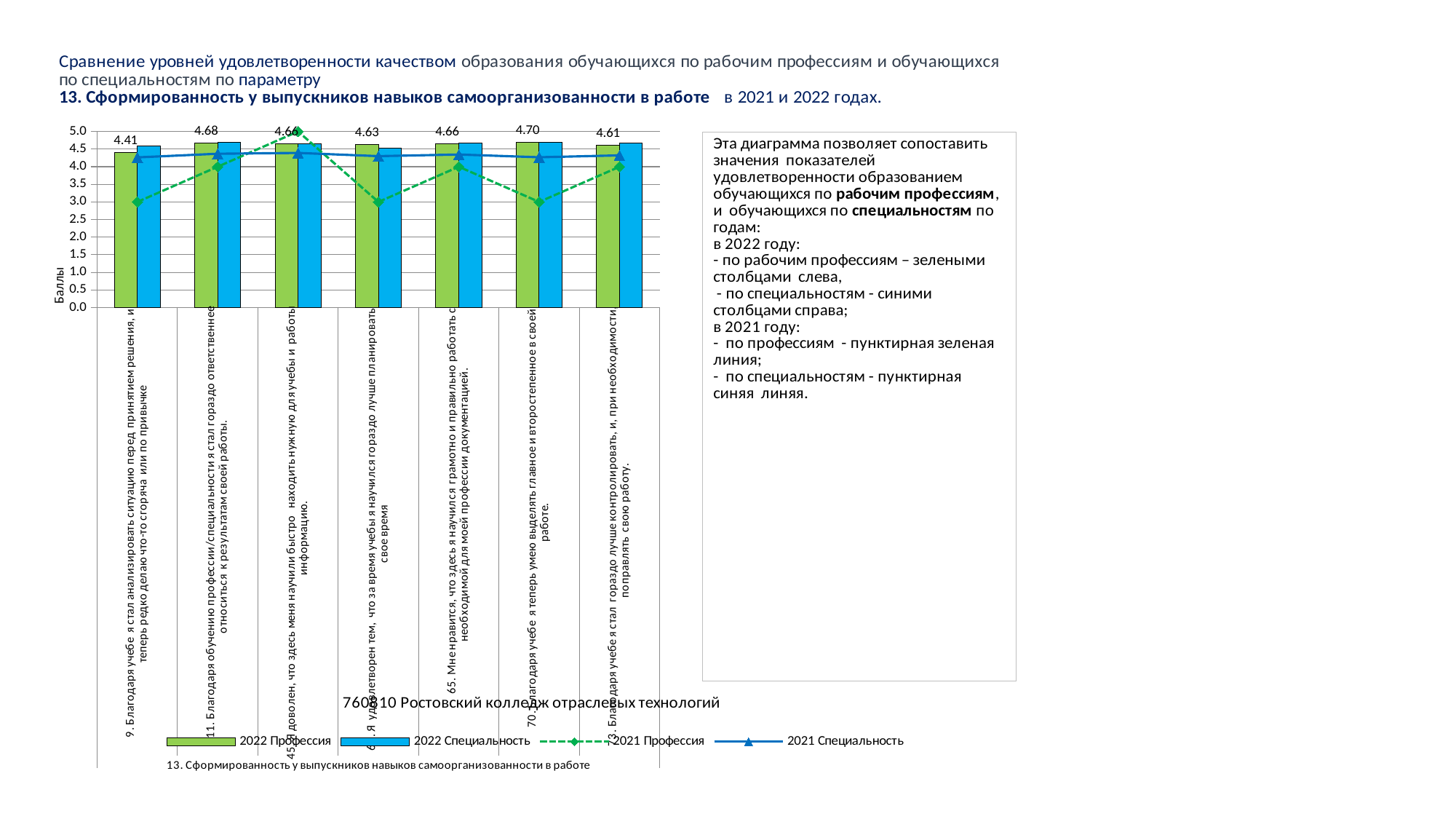
What is the title of the vertical axis of the chart? Баллы What is the value of the 2022 Профессия series for item 9 (Благодаря учебе я стал анализировать ситуацию перед принятием решения)? 4.41 Is the 2021 Профессия value for item 9 greater or less than 3.5? less What is the value of the 2022 Профессия series for item 70 (Благодаря учебе я теперь умею выделять главное и второстепенное в своей работе)? 4.70 How many items (categories) are shown on the x axis of the chart? 7 How many series does the chart legend list? 4 Which item has the highest labelled value for the 2022 Профессия series? 70. Благодаря учебе я теперь умею выделять главное и второстепенное в своей работе (4.70) What kind of chart is shown on the slide? Combined bar and line chart What is the difference between the highest (4.70) and lowest (4.41) labelled values of the 2022 Профессия series? 0.29 Which item has the lowest labelled value for the 2022 Профессия series? 9. Благодаря учебе я стал анализировать ситуацию перед принятием решения (4.41) Is the 2021 Специальность value for item 9 greater or less than 4.0? greater